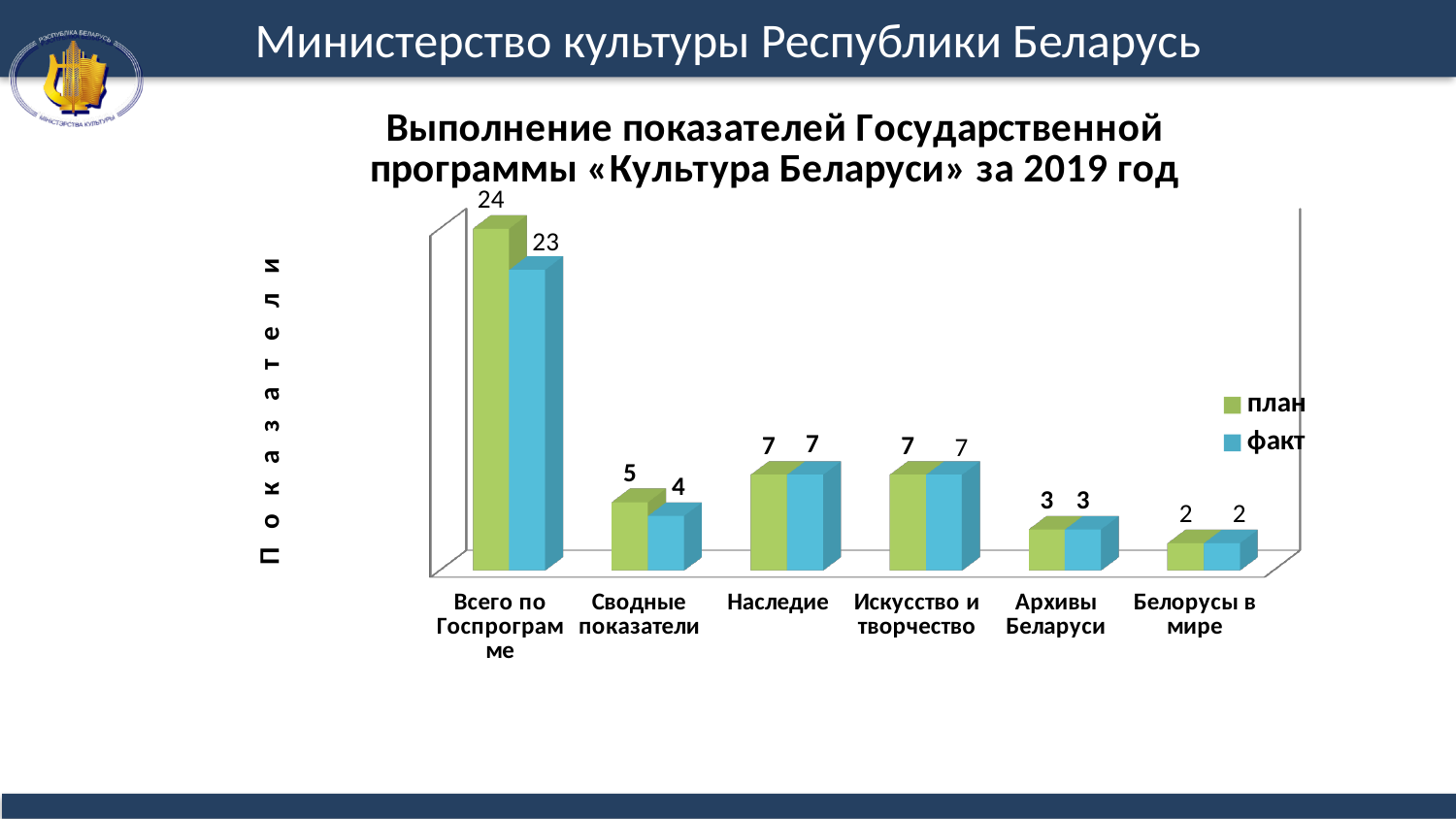
Which category has the highest план value? Всего по Госпрограмме Which is larger for Сводные показатели, the план value or the факт value? план What is the difference between the план and факт values for Всего по Госпрограмме? 1 What kind of chart is shown on the slide? bar chart What are the two series named in the legend? план and факт What is the факт value for Сводные показатели? 4 How many categories are shown on the x axis? 6 Which category has the lowest факт value? Белорусы в мире What is the план value for Всего по Госпрограмме? 24 How many series does the legend list? 2 What is the факт value for Архивы Беларуси? 3 What is the факт value for Наследие? 7